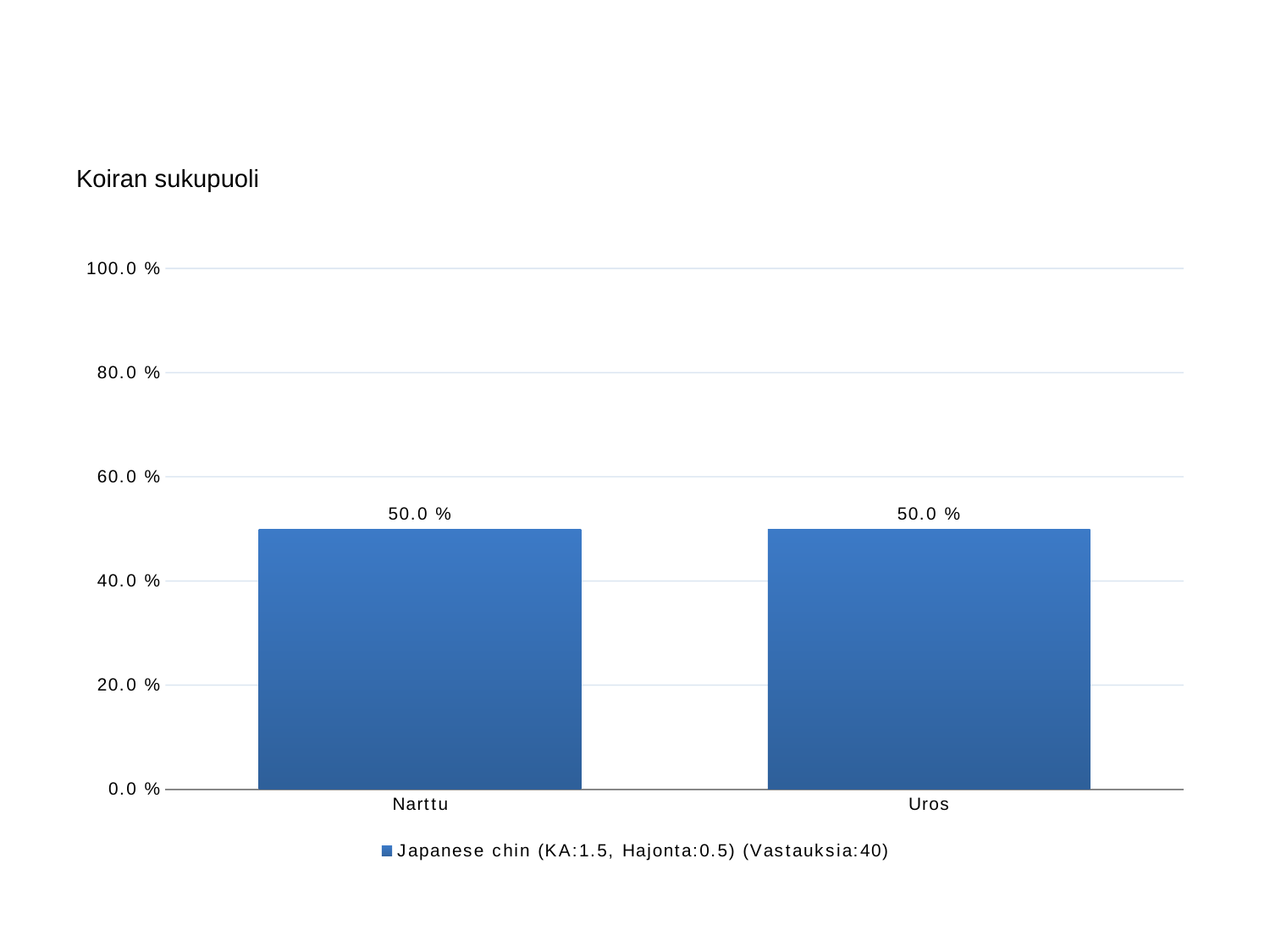
How many categories are shown on the x axis? 2 Is the value for Narttu greater or less than 60.0 %? less What is the value for Narttu? 50.0 % What is the legend entry for the series? Japanese chin (KA:1.5, Hajonta:0.5) (Vastauksia:40) What is the total of the values for Narttu and Uros? 100.0 % What is the difference between the values for Narttu and Uros? 0.0 % How many series does the legend list? 1 Is the value for Uros greater or less than 40.0 %? greater What kind of chart is shown? bar chart What is the title of the chart? Koiran sukupuoli What is the value for Uros? 50.0 %